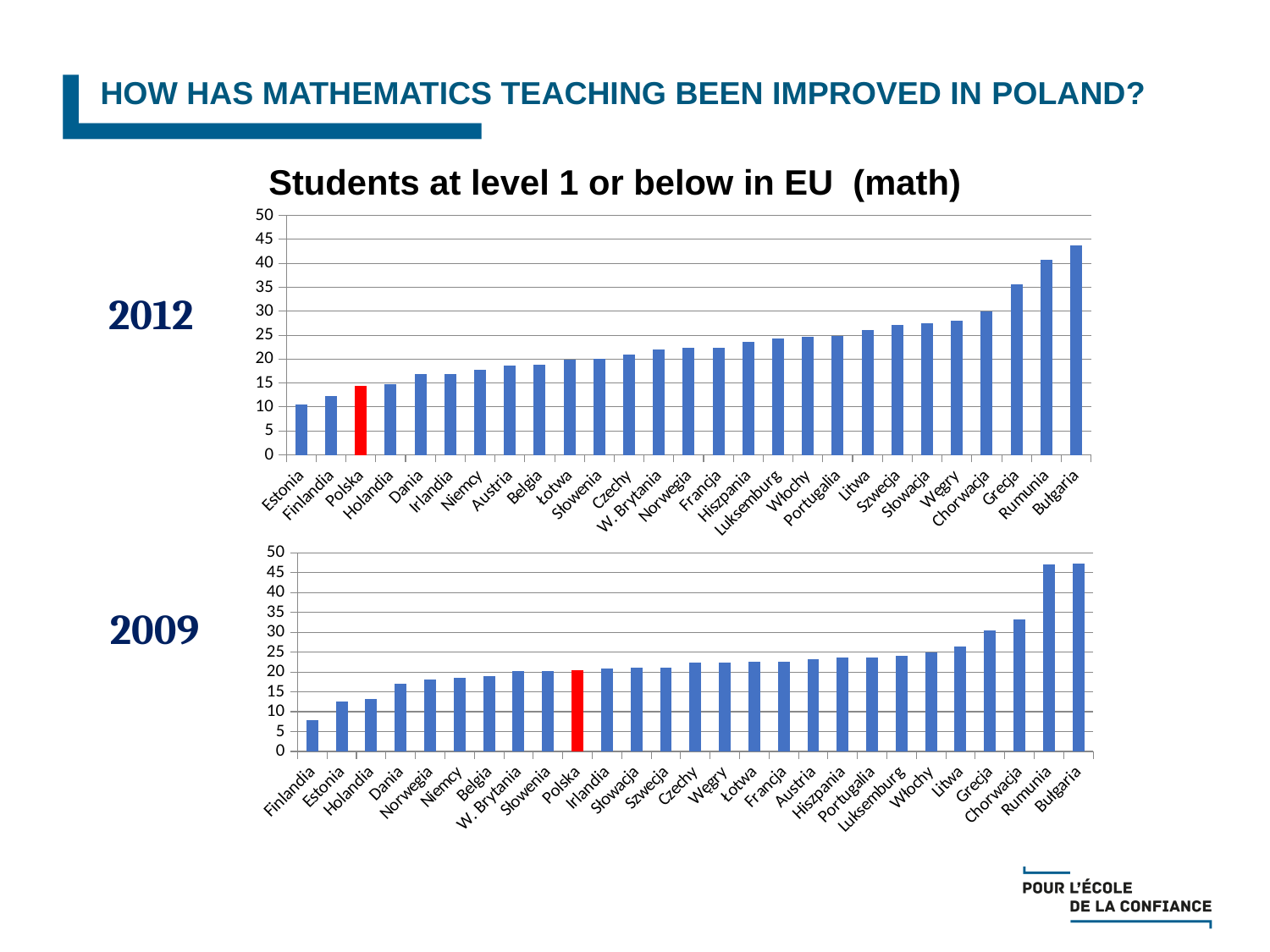
In the 2012 chart, is the value for Estonia greater or less than 15? less In the 2012 chart, which is larger, the value for Rumunia or the value for Grecja? Rumunia In the 2009 chart, is the value for Polska greater or less than 15? greater In the 2012 chart, is the value for Bułgaria greater or less than 40? greater In the 2012 chart, which country has the lowest value? Estonia What kind of chart is the 2012 chart? bar chart How many countries are shown in the 2012 chart? 27 In the 2009 chart, which is larger, the value for Estonia or the value for Finlandia? Estonia In the 2009 chart, which country's bar is coloured red? Polska In the 2012 chart, which country has the highest value? Bułgaria In the 2009 chart, which country has the lowest value? Finlandia